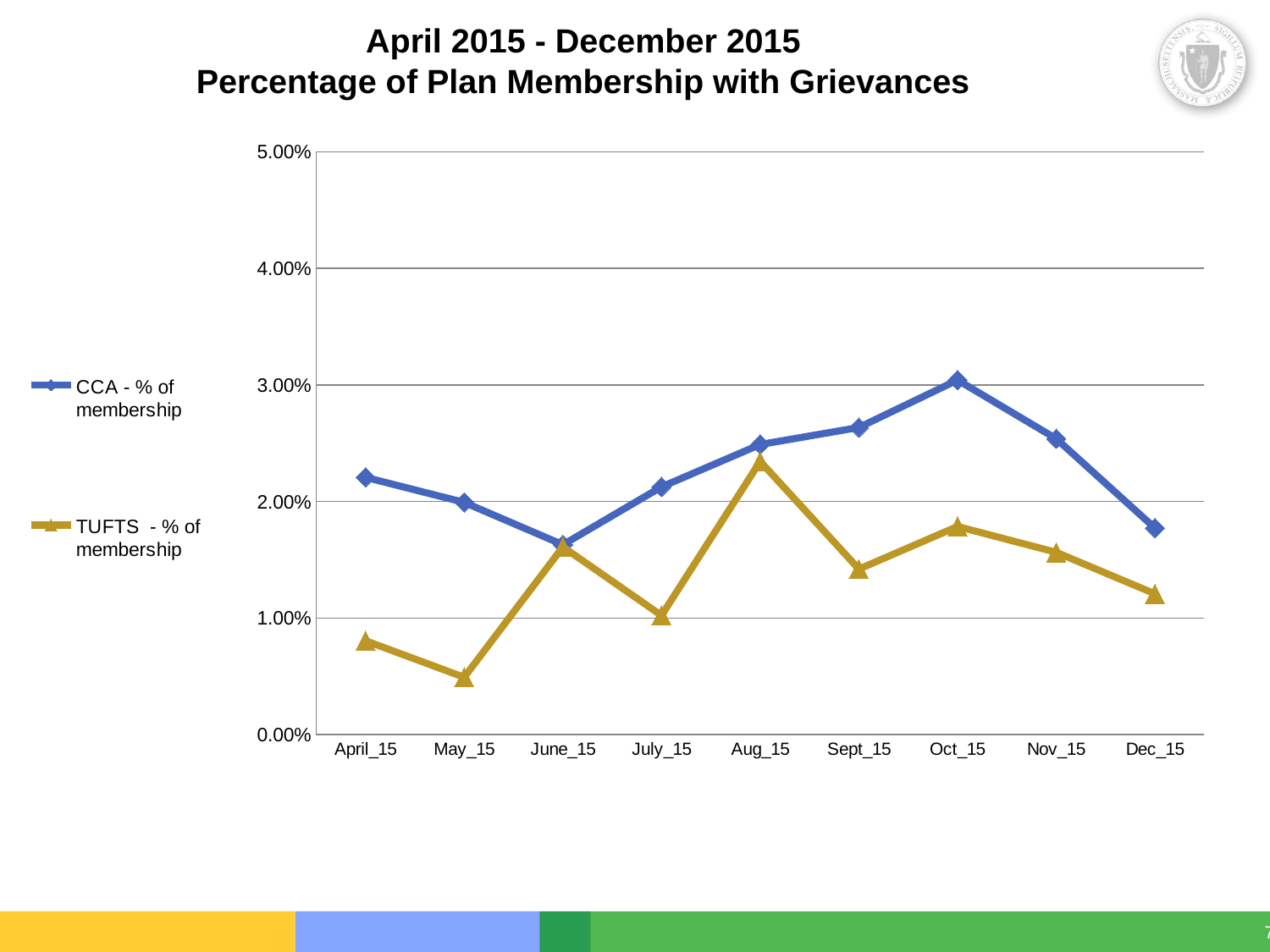
What kind of chart is shown on the slide? line chart How many months are plotted along the x axis? 9 How many series does the legend list? 2 Does the CCA - % of membership series rise or fall from Oct_15 to Dec_15? fall Is the value for TUFTS - % of membership in May_15 greater or less than 1.00%? less Is the value for CCA - % of membership in April_15 greater or less than 2.00%? greater Which series has the larger value in Sept_15, CCA - % of membership or TUFTS - % of membership? CCA - % of membership In which month does the CCA - % of membership series reach its highest value? Oct_15 Is the value for CCA - % of membership in Dec_15 greater or less than 2.00%? less In which month does the TUFTS - % of membership series reach its lowest value? May_15 What is the title of the chart? April 2015 - December 2015 Percentage of Plan Membership with Grievances In which month does the TUFTS - % of membership series reach its highest value? Aug_15